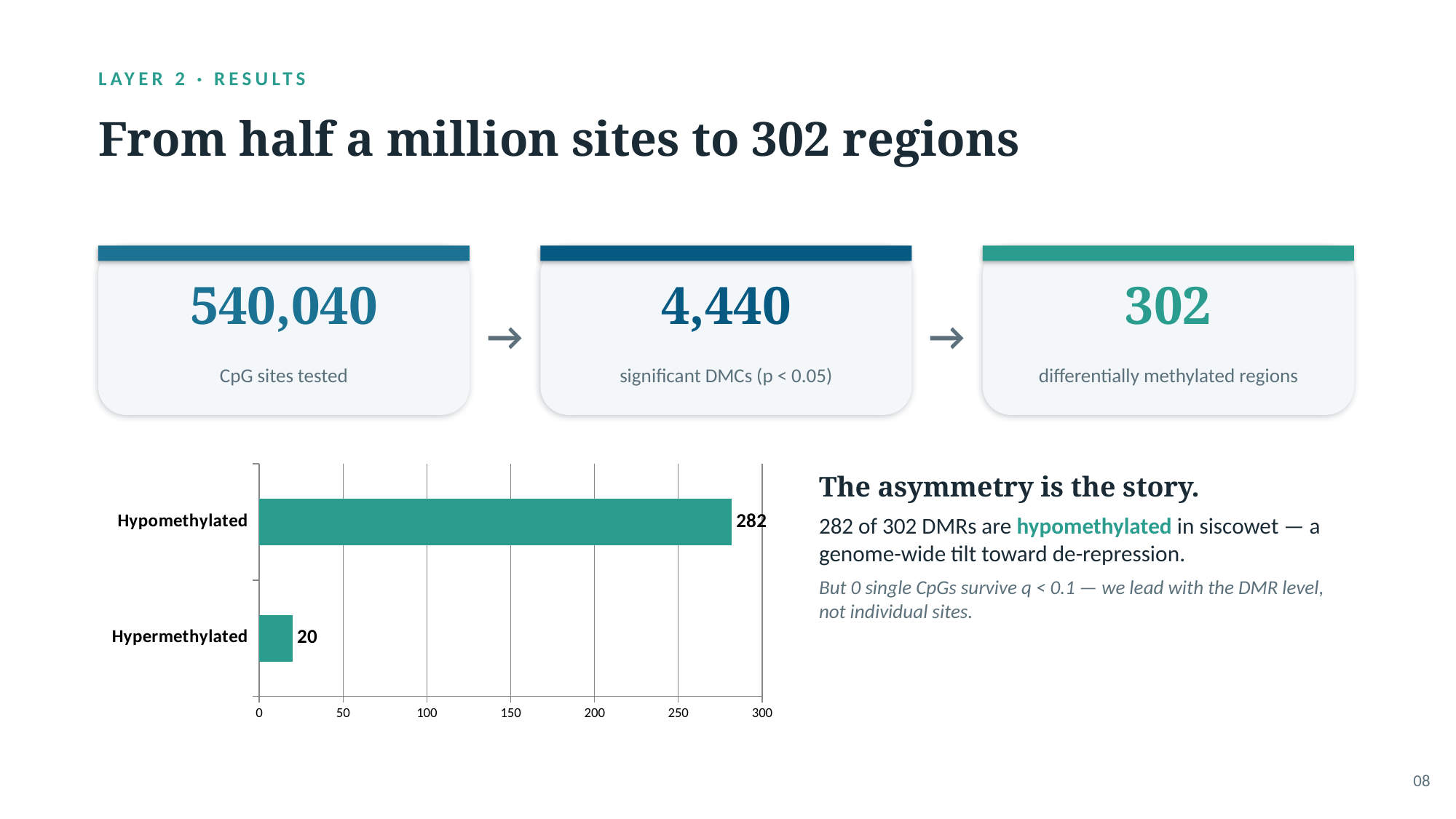
What is the value for Hypermethylated? 20 What is the total of the Hypomethylated and Hypermethylated values? 302 Is the value for Hypermethylated greater or less than 50? less What is the value for Hypomethylated? 282 What is the difference between the Hypomethylated and Hypermethylated values? 262 What kind of chart is shown on the slide? Bar chart Which is larger, the value for Hypomethylated or the value for Hypermethylated? Hypomethylated Which category has the highest value? Hypomethylated How many categories are shown in the chart? 2 Is the value for Hypomethylated greater or less than 250? greater What is the maximum value shown on the chart's x axis? 300 Which category has the lowest value? Hypermethylated